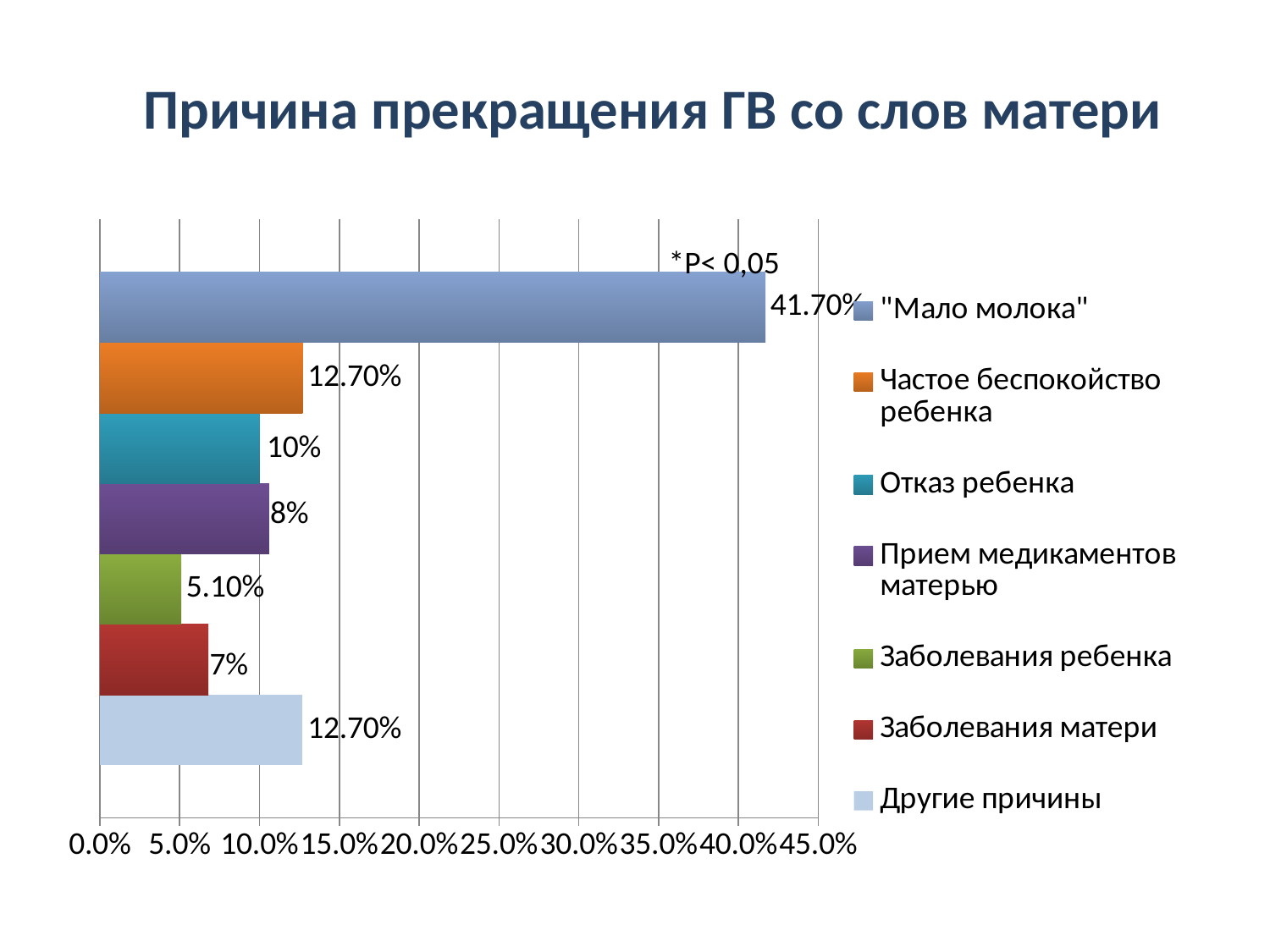
What is the difference between the values for "Мало молока" and Другие причины? 29% Which category has the highest value? "Мало молока" Which is larger, the value for Отказ ребенка or the value for Заболевания матери? Отказ ребенка What is the value for Заболевания ребенка? 5.10% What is the value for Заболевания матери? 7% Is the value for "Мало молока" greater or less than 40.0%? greater How many entries does the legend list? 7 What is the value for Частое беспокойство ребенка? 12.70% Which category has the lowest value? Заболевания ребенка What kind of chart is shown on the slide? bar chart What is the value for "Мало молока"? 41.70% What is the value for Отказ ребенка? 10%